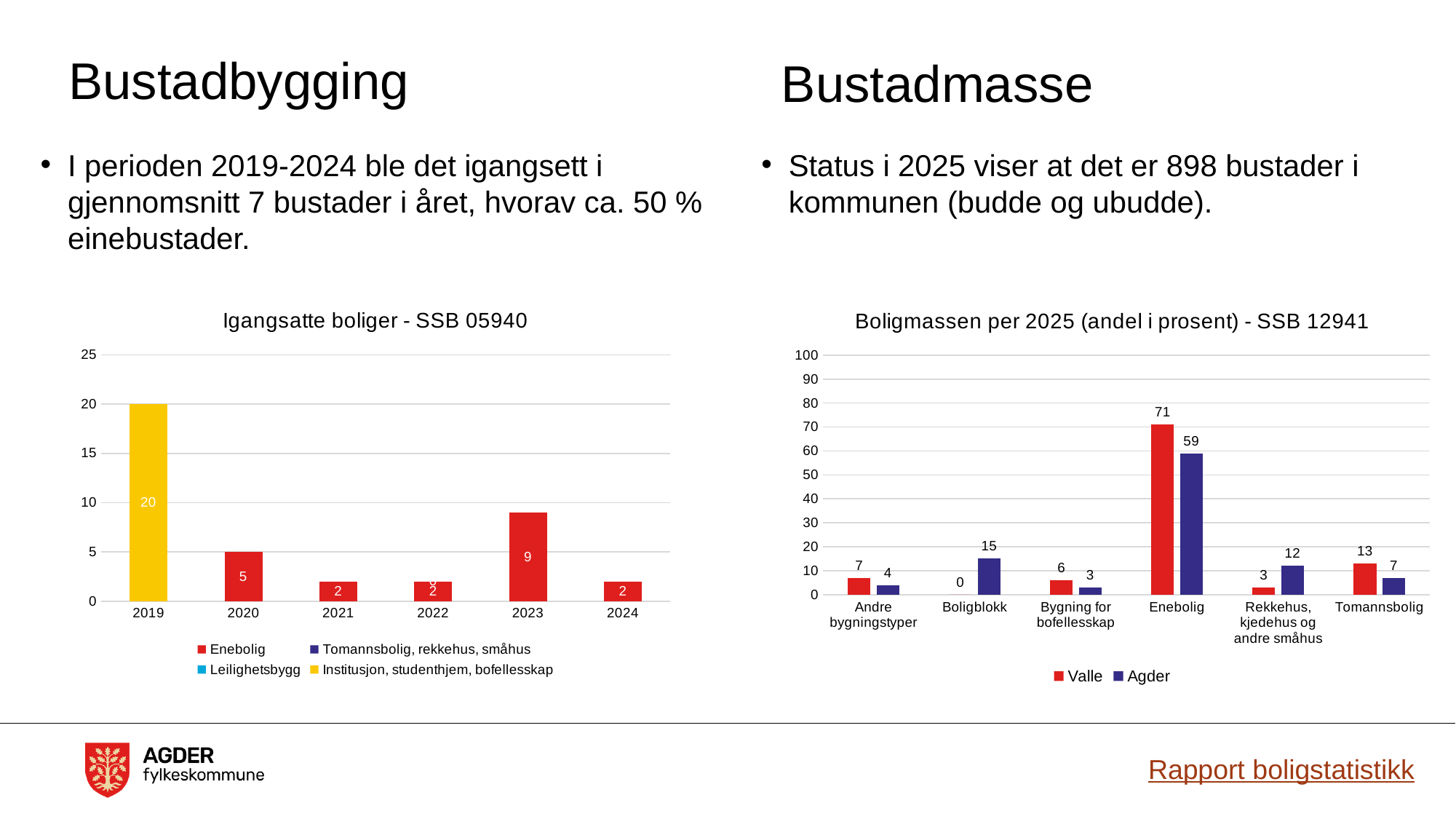
In the chart 'Igangsatte boliger - SSB 05940', how many years are shown on the x axis? 6 In the chart 'Igangsatte boliger - SSB 05940', which year has the highest value? 2019 In the chart 'Boligmassen per 2025 (andel i prosent) - SSB 12941', what is the value for Agder for Boligblokk? 15 In the chart 'Igangsatte boliger - SSB 05940', what is the value for 2019? 20 In the chart 'Boligmassen per 2025 (andel i prosent) - SSB 12941', which is larger for Tomannsbolig, Valle or Agder? Valle In the chart 'Boligmassen per 2025 (andel i prosent) - SSB 12941', which category has the lowest value for Valle? Boligblokk In the chart 'Igangsatte boliger - SSB 05940', what is the difference between the values for 2020 and 2021? 3 In the chart 'Boligmassen per 2025 (andel i prosent) - SSB 12941', what is the difference between Valle and Agder for Enebolig? 12 In the chart 'Igangsatte boliger - SSB 05940', how many series does the legend list? 4 What kind of chart is 'Boligmassen per 2025 (andel i prosent) - SSB 12941'? Bar chart In the chart 'Igangsatte boliger - SSB 05940', what is the value for 2023? 9 In the chart 'Boligmassen per 2025 (andel i prosent) - SSB 12941', what is the value for Valle for Enebolig? 71